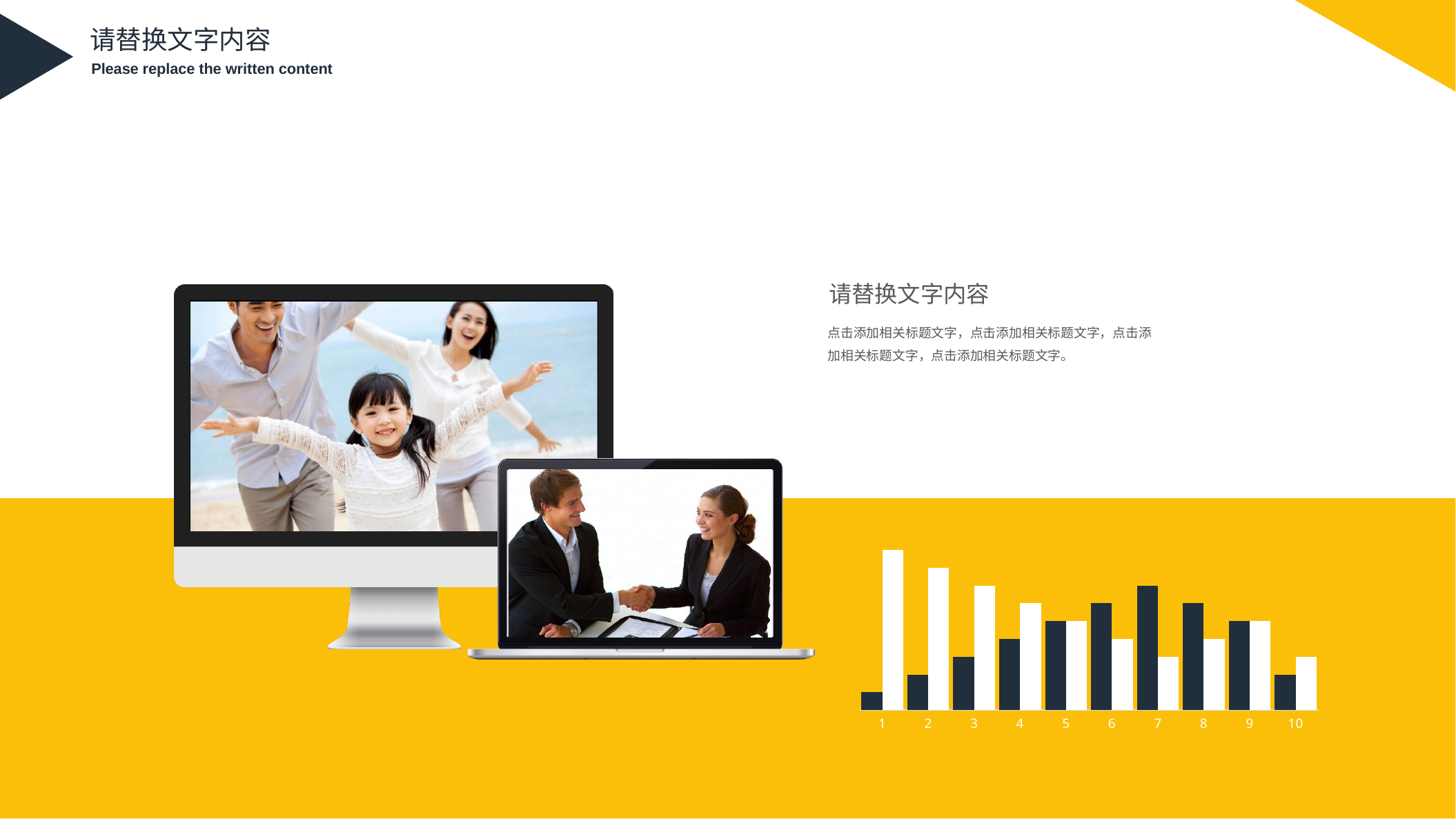
In the bar chart, which category has the shortest dark bar? 1 What two colours are used for the bars in the chart? dark navy and white In the bar chart, which category has the tallest white bar? 1 How many data series are plotted in the bar chart? 2 How many categories are shown on the x axis of the bar chart? 10 In the bar chart, at category 1, which bar is taller, the dark bar or the white bar? the white bar What kind of chart is shown at the bottom right of the slide? bar chart In the bar chart, which category has the tallest dark bar? 7 In the bar chart, do the white bars rise or fall from category 1 to category 4? fall In the bar chart, at category 7, which bar is taller, the dark bar or the white bar? the dark bar In the bar chart, at category 3, which bar is taller, the dark bar or the white bar? the white bar In the bar chart, do the dark bars rise or fall from category 1 to category 7? rise